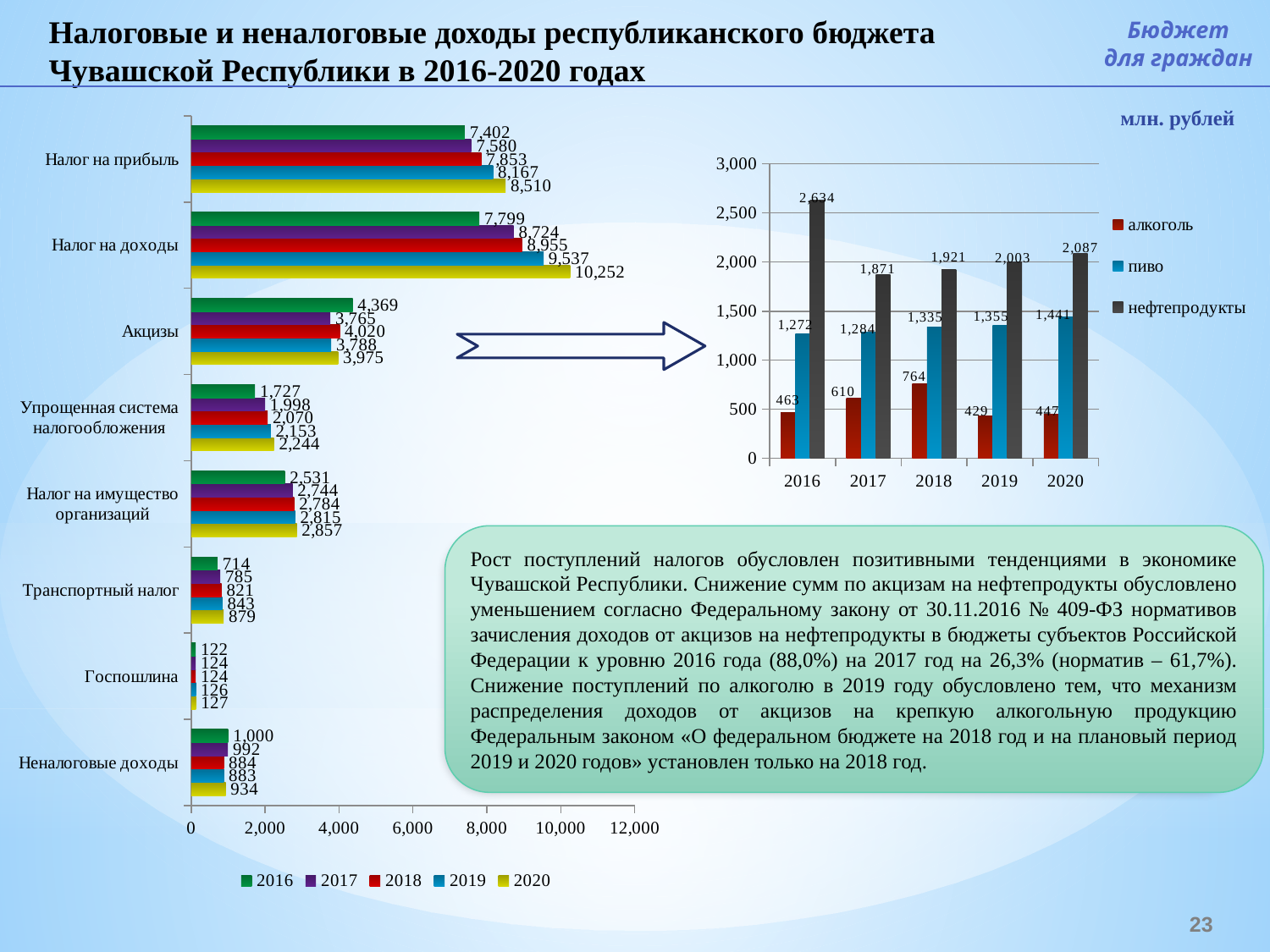
In the right chart, what is the difference between пиво in 2020 and пиво in 2016? 169 What type of chart is the right chart? bar chart In the right chart, what is the value for нефтепродукты in 2016? 2,634 In the left chart, which category has the lowest values across all years? Госпошлина In the left chart, how many categories are shown on the vertical axis? 8 In the left chart, what is the difference between the 2020 and 2016 values for Налог на прибыль? 1,108 In the right chart, which is larger: нефтепродукты in 2017 or нефтепродукты in 2018? нефтепродукты in 2018 In the left chart, what is the value for Акцизы in 2016? 4,369 In the left chart, how many series does the legend list? 5 In the left chart, do the values for Транспортный налог rise or fall from 2016 to 2020? rise In the left chart, what is the value for Налог на доходы in 2020? 10,252 In the right chart, which year has the highest value for алкоголь? 2018